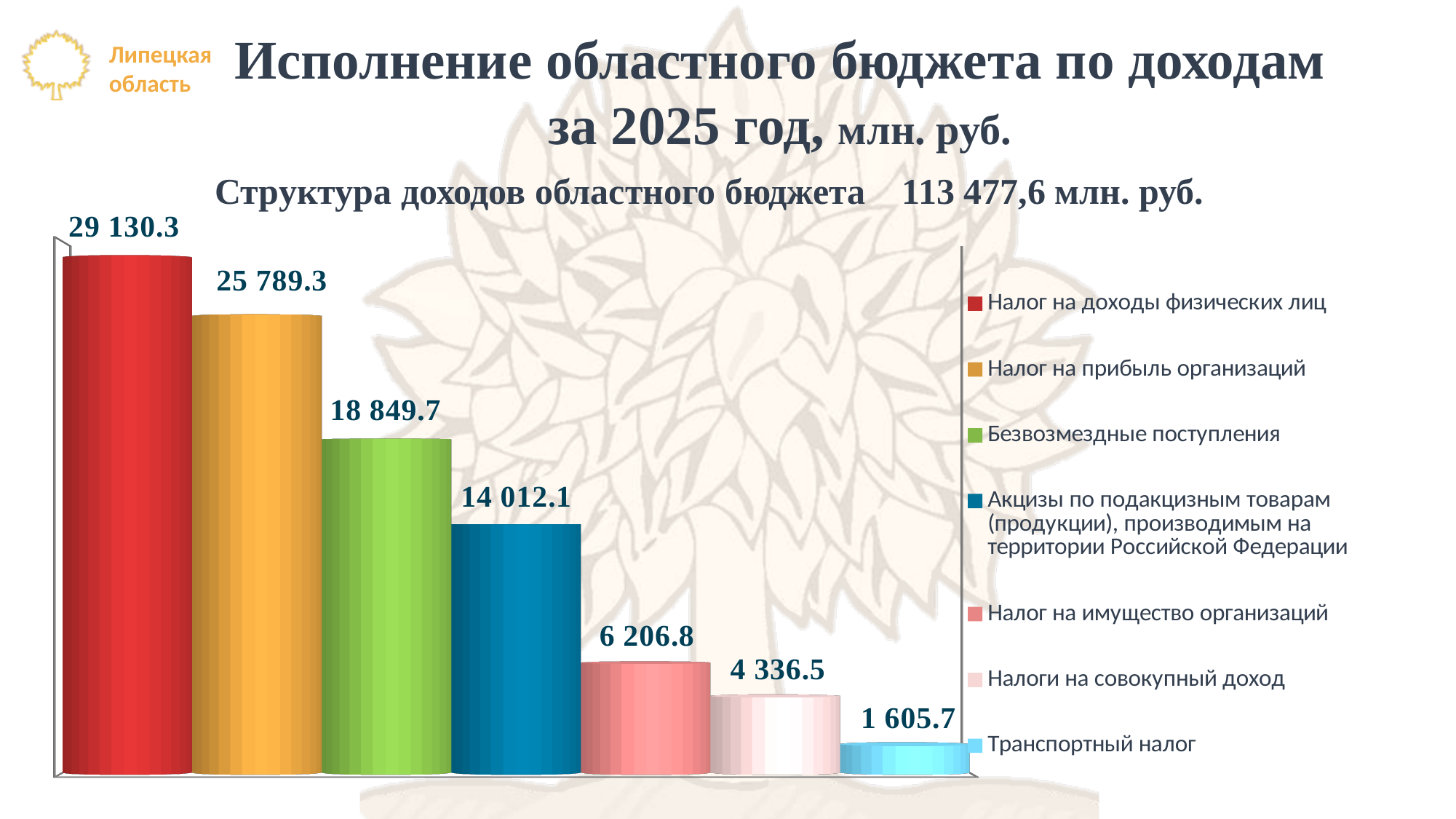
What kind of chart is shown on the slide? Bar chart How many bars are plotted in the chart? 7 What total is stated in the chart heading 'Структура доходов областного бюджета'? 113 477,6 млн. руб. Which category has the highest value? Налог на доходы физических лиц What is the value for Безвозмездные поступления? 18 849.7 What is the value for Транспортный налог? 1 605.7 Which is larger: Безвозмездные поступления or Акцизы по подакцизным товарам (продукции), производимым на территории Российской Федерации? Безвозмездные поступления Which category has the lowest value? Транспортный налог What is the difference between Налог на имущество организаций and Налоги на совокупный доход? 1 870.3 What is the difference between Налог на доходы физических лиц and Налог на прибыль организаций? 3 341.0 What is the value for Налог на доходы физических лиц? 29 130.3 What is the value for Налоги на совокупный доход? 4 336.5